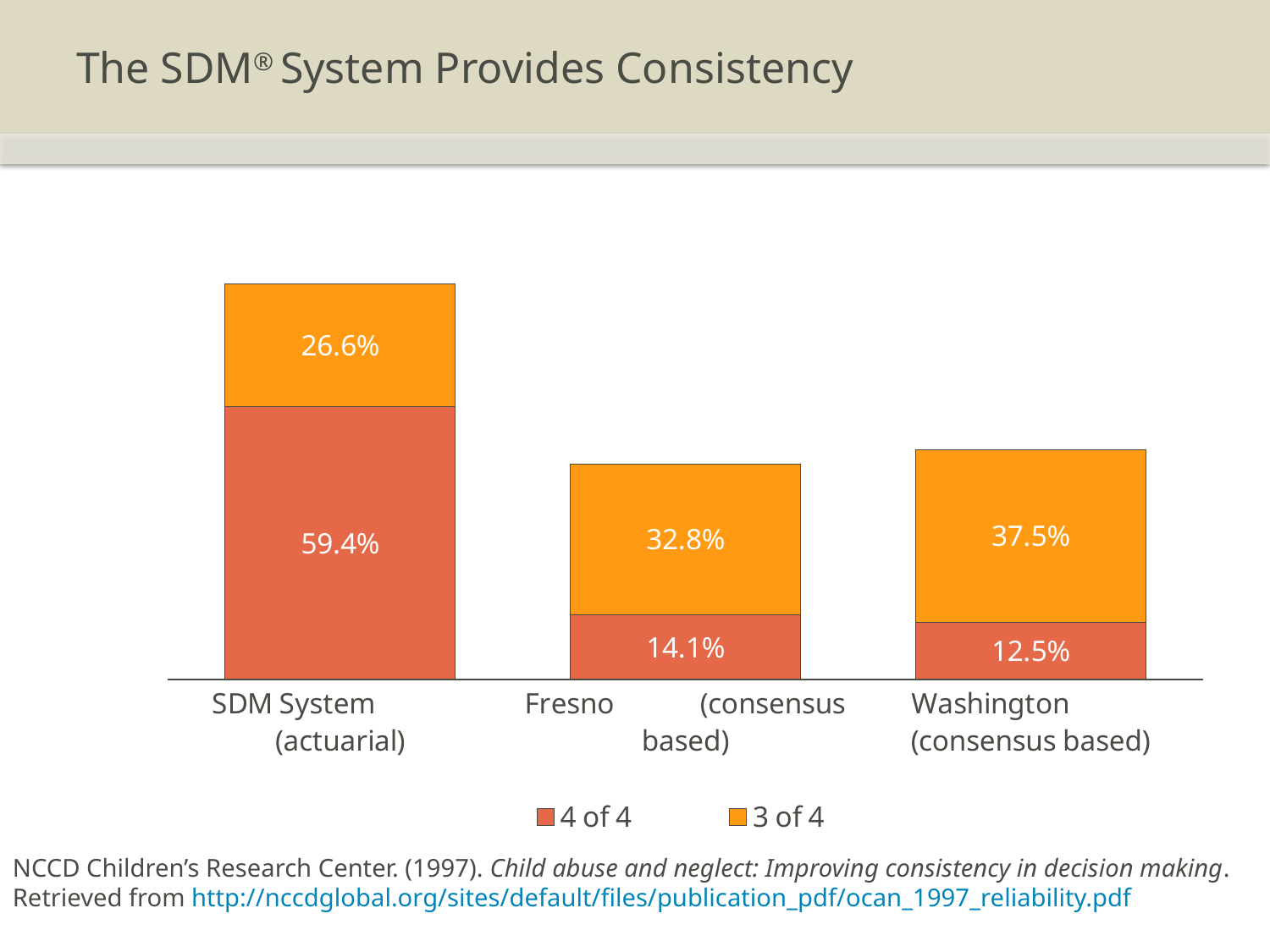
What is the difference between the "4 of 4" values for SDM System (actuarial) and Fresno (consensus based)? 45.3% What is the value of the "4 of 4" series for SDM System (actuarial)? 59.4% What is the total of the stacked bar for SDM System (actuarial)? 86.0% Which category has the highest "4 of 4" value? SDM System (actuarial) What kind of chart is shown on the slide? Stacked bar chart Which is larger: the "3 of 4" value for Fresno (consensus based) or for Washington (consensus based)? Washington (consensus based) How many categories are shown on the x axis? 3 What is the total of the stacked bar for Washington (consensus based)? 50.0% What is the value of the "3 of 4" series for Washington (consensus based)? 37.5% How many series does the legend list? 2 Which category has the lowest "4 of 4" value? Washington (consensus based) What is the value of the "4 of 4" series for Fresno (consensus based)? 14.1%